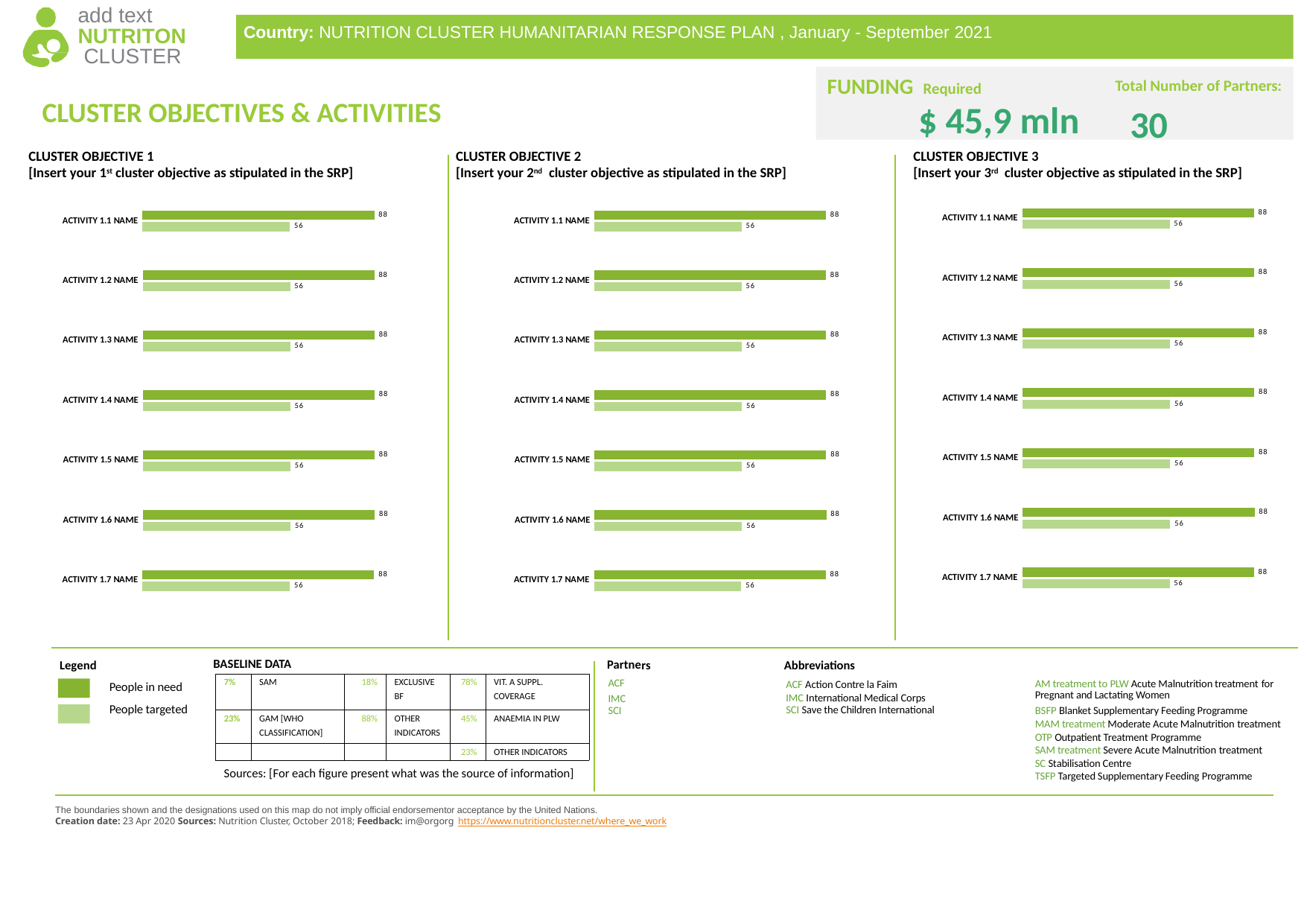
In the Cluster Objective 2 chart, do the People in need values change from ACTIVITY 1.1 NAME to ACTIVITY 1.7 NAME? No, they stay at 88 In the Cluster Objective 2 chart, which is larger for ACTIVITY 1.6 NAME: the People in need bar or the People targeted bar? People in need How many series does the legend list for the activity charts? 2 In the Cluster Objective 3 chart, what is the total of the two bars for ACTIVITY 1.2 NAME? 144 What type of chart is used under Cluster Objective 1? Bar chart In the Cluster Objective 2 chart, what is the value of the light green (People targeted) bar for ACTIVITY 1.4 NAME? 56 According to the legend, which series is shown in light green? People targeted What is the label of the first activity in the Cluster Objective 1 chart? ACTIVITY 1.1 NAME In the Cluster Objective 1 chart, what is the value of the dark green (People in need) bar for ACTIVITY 1.1 NAME? 88 In the Cluster Objective 3 chart, what is the value of the People in need bar for ACTIVITY 1.7 NAME? 88 In the Cluster Objective 1 chart, what is the difference between the People in need and People targeted values for ACTIVITY 1.3 NAME? 32 How many activities are listed in the Cluster Objective 3 chart? 7